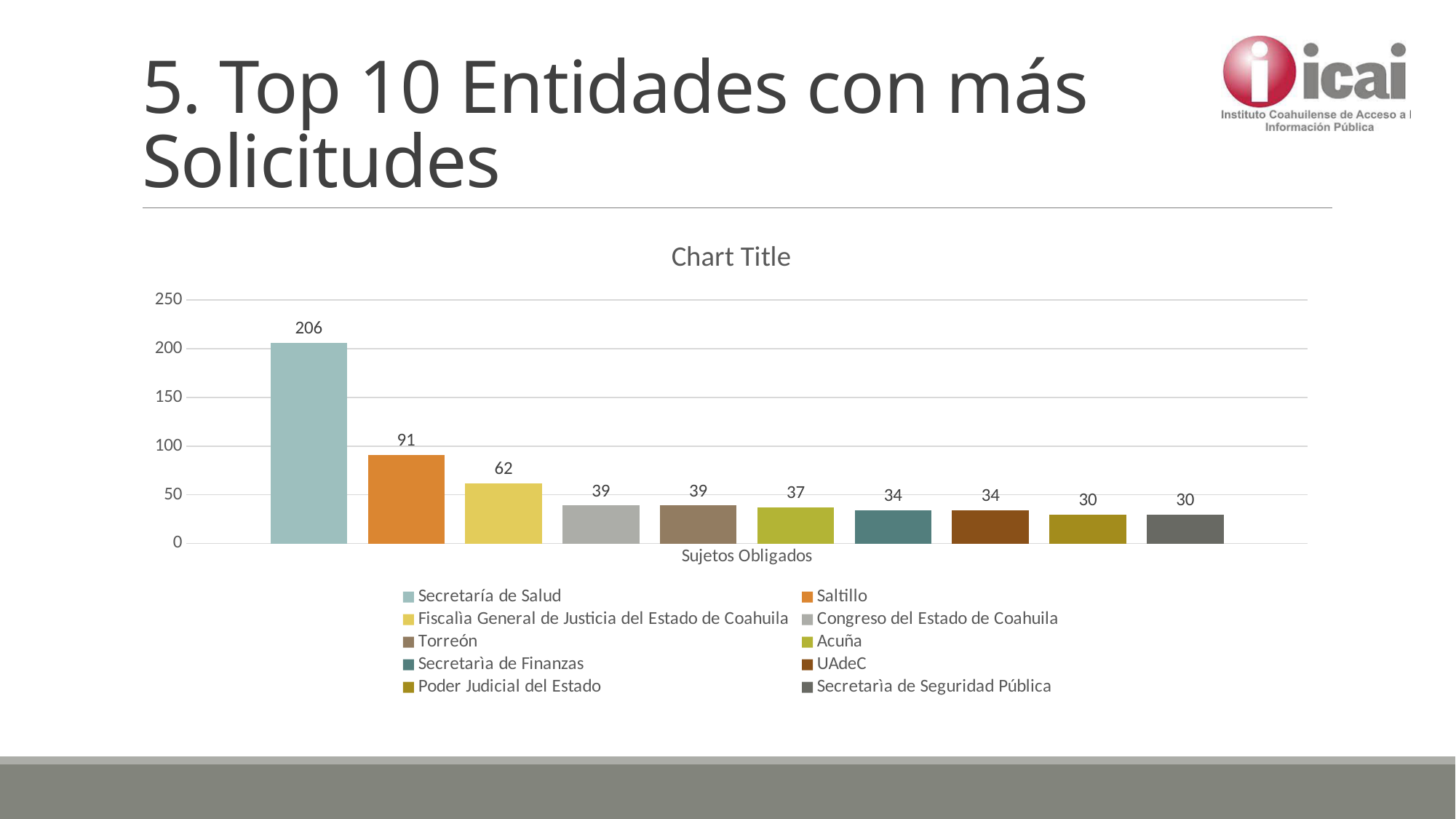
Which entity has the highest value? Secretaría de Salud How many bars are plotted in the chart? 10 What is the value for Acuña? 37 What is the value for Fiscalìa General de Justicia del Estado de Coahuila? 62 What kind of chart is shown on the slide? Bar chart What is the value for Saltillo? 91 How many entries does the legend list? 10 What is the difference between the values for Secretaría de Salud and Saltillo? 115 Which is larger, the value for Torreón or the value for Poder Judicial del Estado? Torreón What is the value for Secretaría de Salud? 206 What is the difference between the values for Saltillo and Fiscalìa General de Justicia del Estado de Coahuila? 29 What is the value for UAdeC? 34